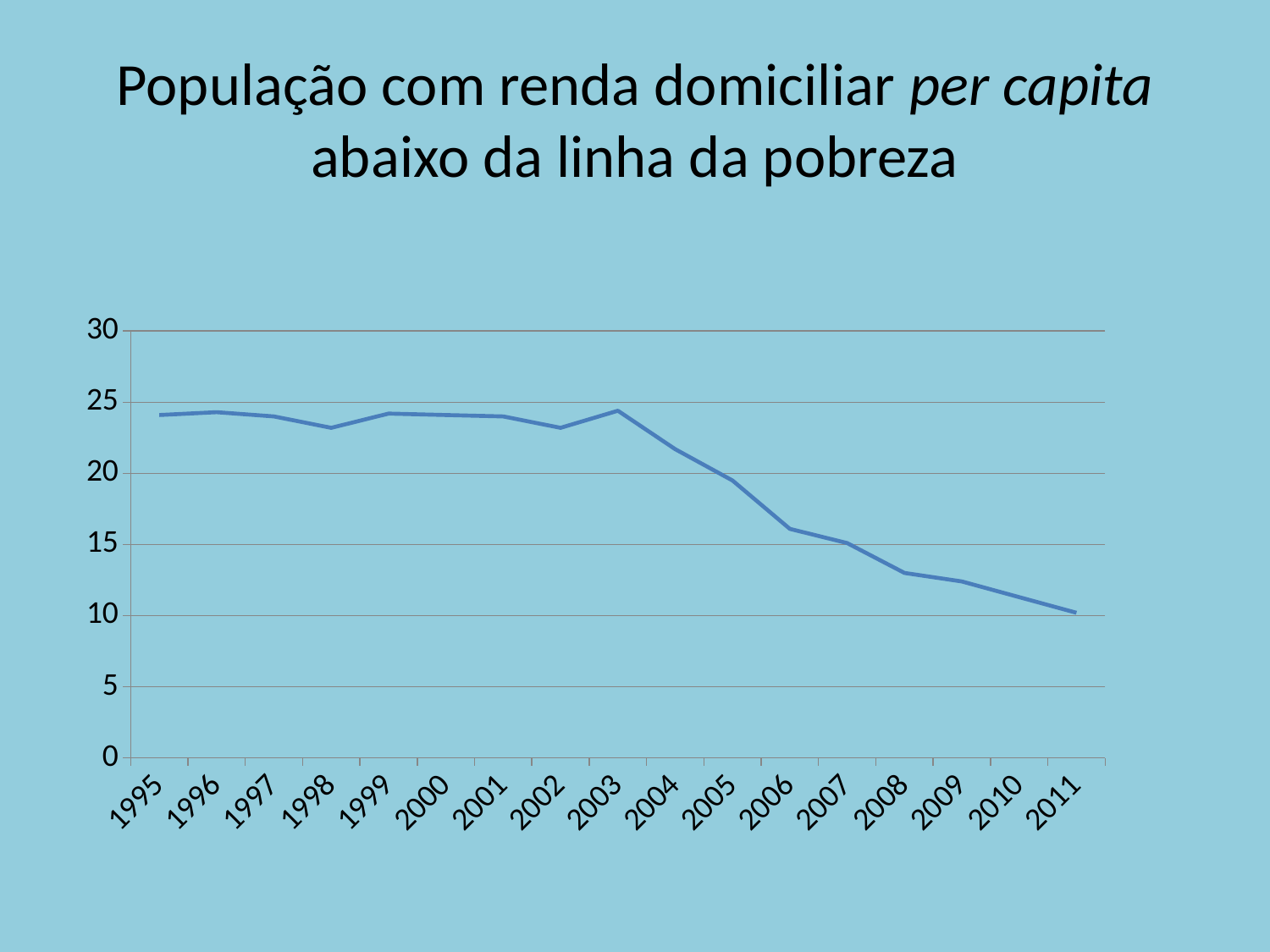
Is the value for 1995 greater or less than 20? greater Is the value for 2011 greater or less than 15? less Which year has the lowest value on the chart? 2011 What kind of chart is shown on the slide? line chart Do the values rise or fall from 2003 to 2011? fall Is the value for 2004 greater or less than 20? greater How many years are plotted along the x axis? 17 Which year has the larger value, 2009 or 1999? 1999 What is the title of the chart on the slide? População com renda domiciliar per capita abaixo da linha da pobreza Which year has the larger value, 2003 or 2011? 2003